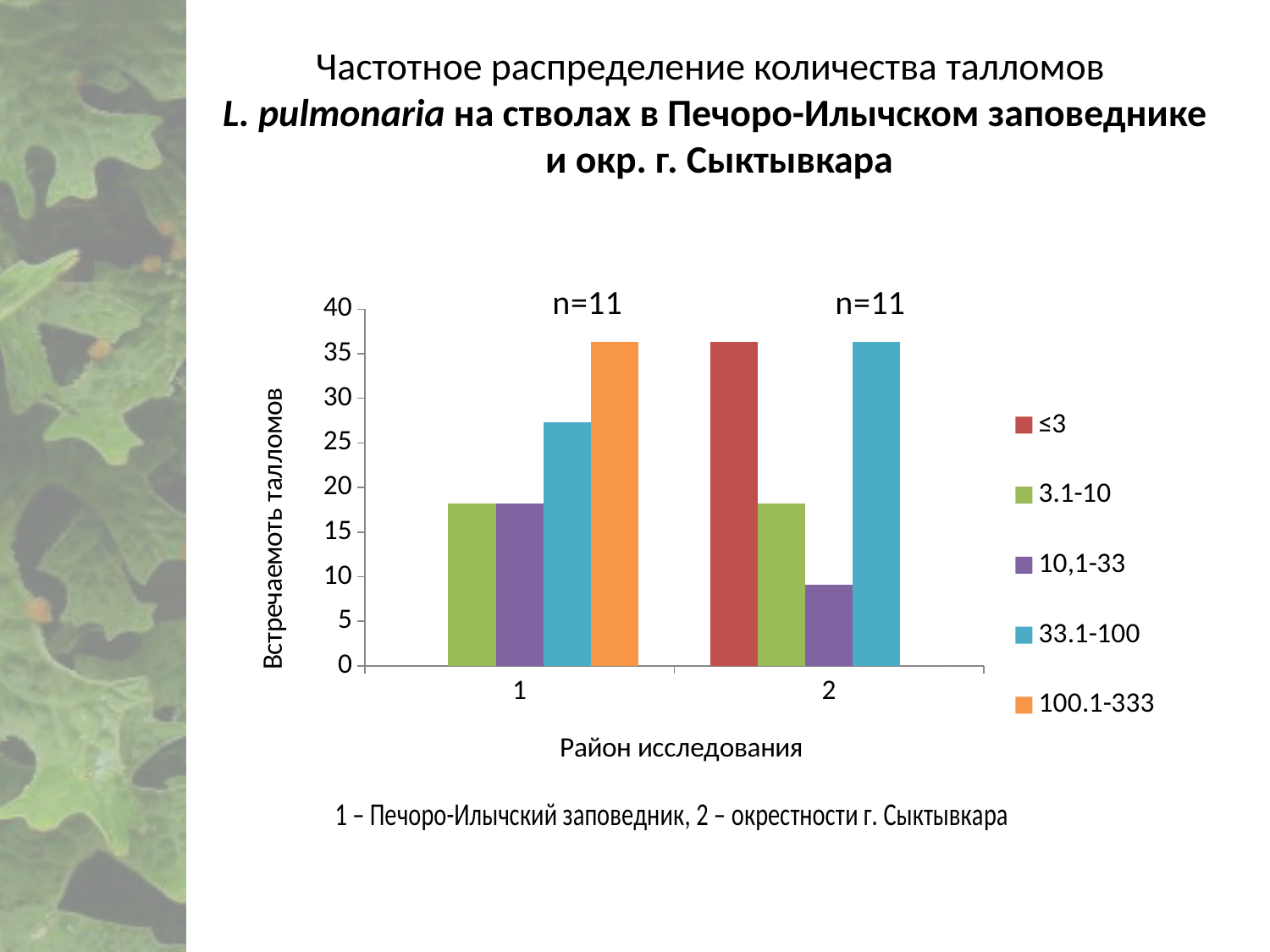
How many series does the legend list? 5 What kind of chart is shown on the slide? bar chart In category 1, which is larger: the value for 33.1-100 or the value for 3.1-10? 33.1-100 What sample size label is printed above each group of bars? n=11 In category 2, which of the plotted series has the lowest bar? 10,1-33 Is the value for 33.1-100 in category 1 greater or less than 25? greater In category 2, which is larger: the value for ≤3 or the value for 3.1-10? ≤3 Is the value for 100.1-333 in category 1 greater or less than 30? greater Is the value for 10,1-33 in category 2 greater or less than 15? less What is the title of the x axis? Район исследования In category 1, which series has the highest bar? 100.1-333 How many categories are shown on the x axis? 2